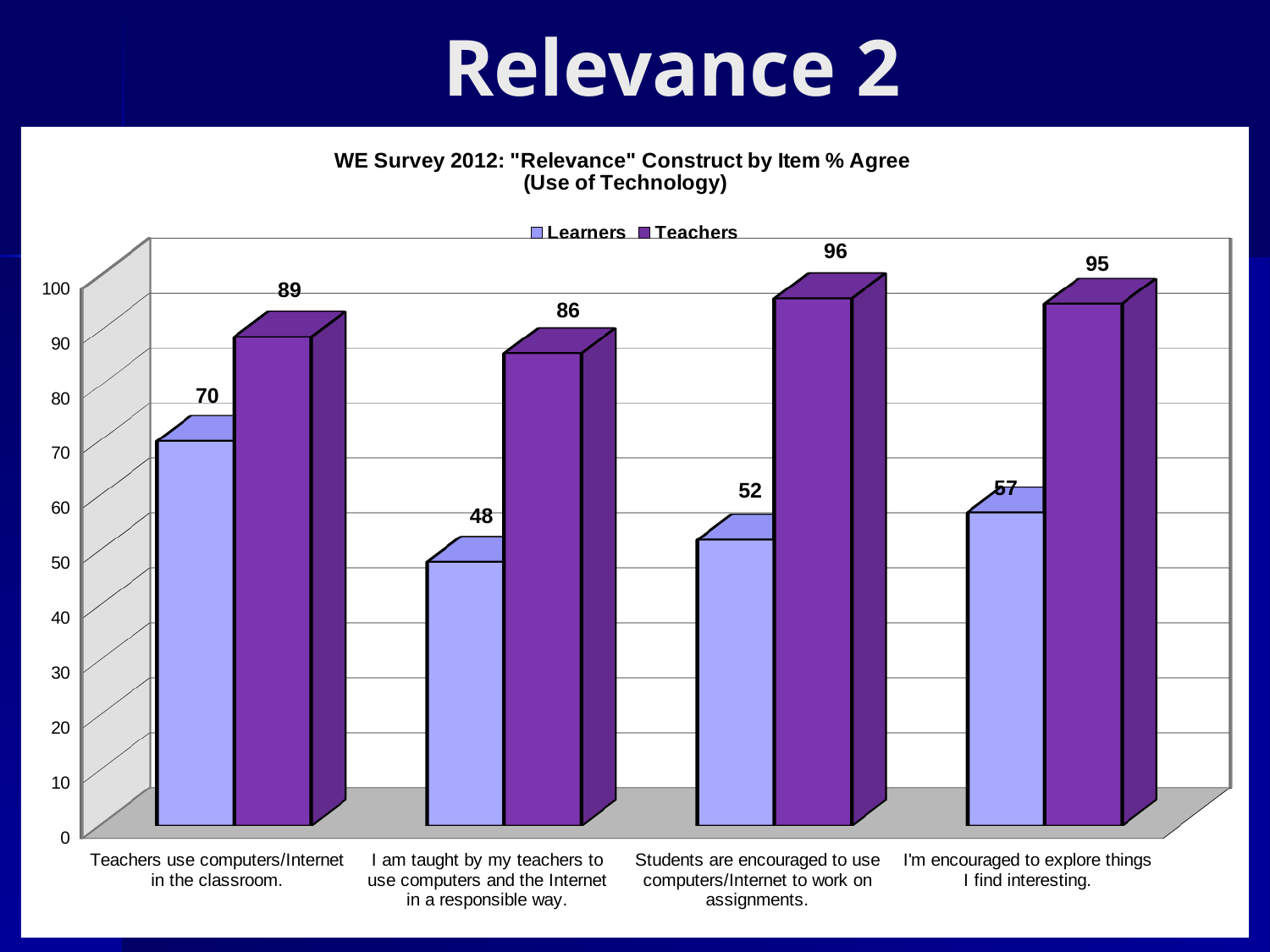
What is the Learners value for "Teachers use computers/Internet in the classroom."? 70 Which item has the lowest Learners value? I am taught by my teachers to use computers and the Internet in a responsible way. Which series is shown in purple? Teachers What is the title of the chart? WE Survey 2012: "Relevance" Construct by Item % Agree (Use of Technology) How many series does the legend list? 2 What is the Teachers value for "Students are encouraged to use computers/Internet to work on assignments."? 96 How many items (categories) are shown on the x axis? 4 What is the difference between the Teachers and Learners values for "I am taught by my teachers to use computers and the Internet in a responsible way."? 38 Which is larger for "Teachers use computers/Internet in the classroom.": the Learners value or the Teachers value? Teachers Which item has the highest Teachers value? Students are encouraged to use computers/Internet to work on assignments. What is the Learners value for "I'm encouraged to explore things I find interesting."? 57 What kind of chart is shown on the slide? Bar chart